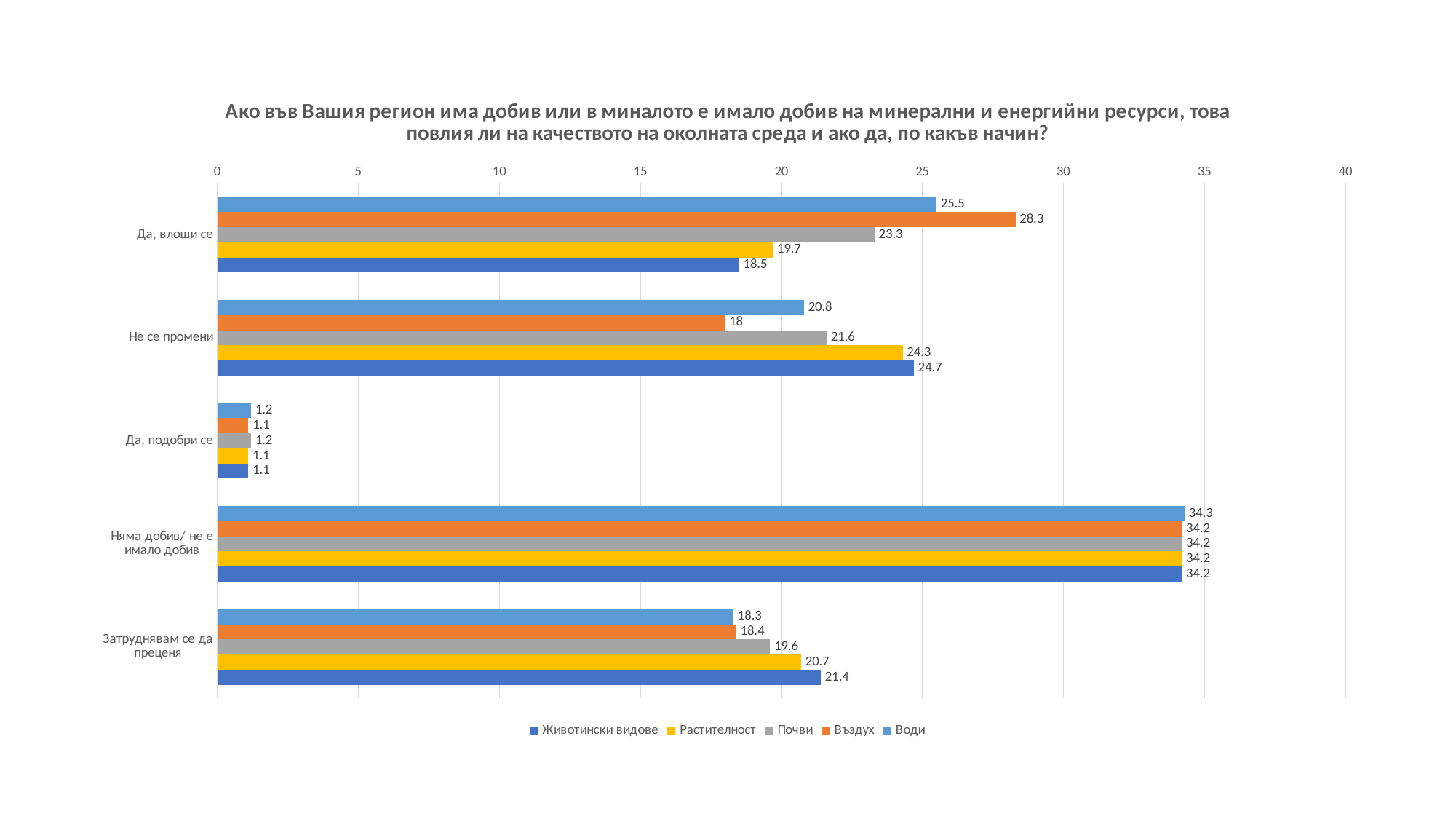
Is the value for Почви in the category "Не се промени" greater or less than 20? greater What is the value for Почви in the category "Затруднявам се да преценя"? 19.6 How many categories are shown on the vertical axis? 5 In the category "Затруднявам се да преценя", which is larger: the value for Растителност or the value for Води? Растителност What is the value for Въздух in the category "Да, влоши се"? 28.3 What is the difference between the Въздух and Животински видове values in the category "Да, влоши се"? 9.8 How many series does the legend list? 5 What is the value for Води in the category "Няма добив/ не е имало добив"? 34.3 What kind of chart is shown on the slide? Bar chart What is the value for Животински видове in the category "Не се промени"? 24.7 Which series has the highest value in the category "Да, влоши се"? Въздух Which series has the lowest value in the category "Не се промени"? Въздух